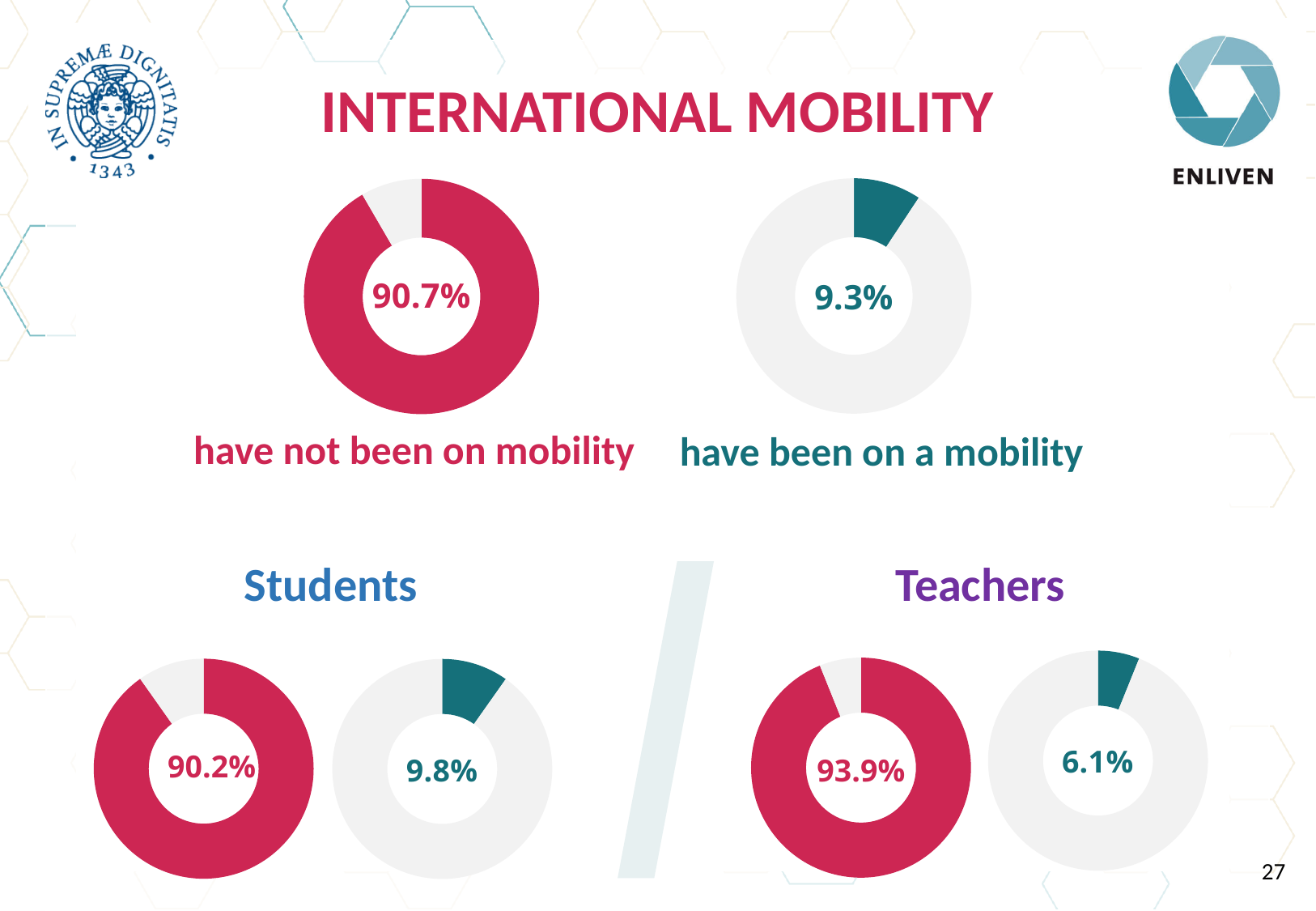
What is the difference between the Students' and Teachers' shares that have been on a mobility? 3.7% In the Teachers section, what percentage of teachers have been on a mobility? 6.1% In the top-right donut chart, what percentage have been on a mobility? 9.3% In the Teachers section, what percentage of teachers have not been on mobility? 93.9% In the Students section, what percentage of students have not been on mobility? 90.2% In the top-left donut chart, what percentage have not been on mobility? 90.7% What is the difference between the Teachers' and Students' shares that have not been on mobility? 3.7% How many donut charts are shown on the slide? 6 Comparing the Students and Teachers charts, which group has the higher share that has been on a mobility? Students In the Students section, what percentage of students have been on a mobility? 9.8% What colour is used for the 'have been on a mobility' segments in the charts? Teal What type of chart is used to show the mobility percentages on this slide? Donut (pie) chart